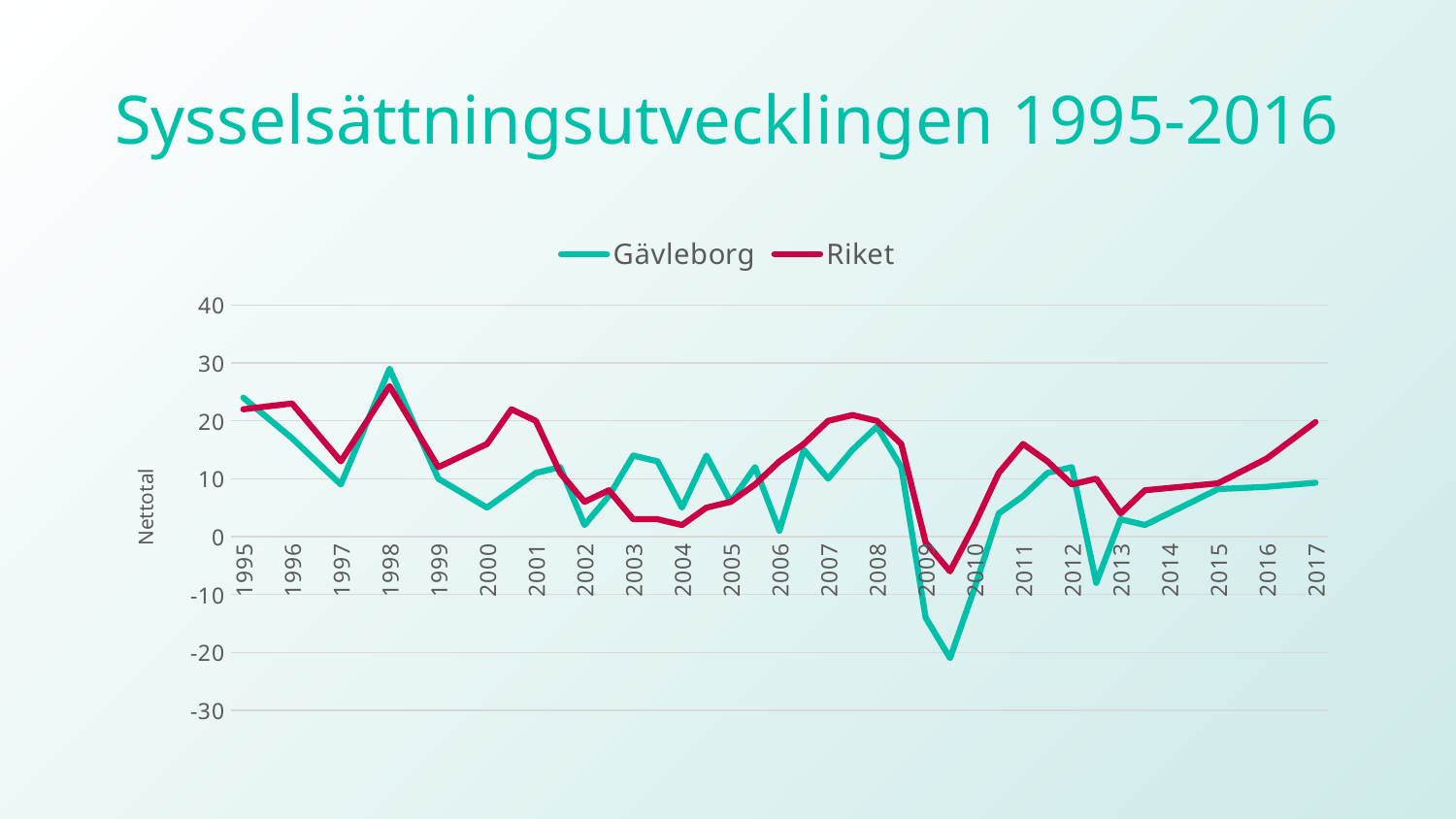
What kind of chart is shown on the slide? Line chart How many series does the legend list? 2 Does the Riket line rise or fall between 2013 and 2017? Rise Is the value for Gävleborg at 1998 greater or less than 20? greater Which series is higher at 2017, Gävleborg or Riket? Riket How many year labels are shown on the x axis? 23 What is the label on the vertical axis? Nettotal Is the lowest value for Gävleborg around 2009 greater or less than -10? less Which series reaches the lowest value on the chart? Gävleborg What is the title of the chart on the slide? Sysselsättningsutvecklingen 1995-2016 Is the value for Riket at 2017 greater or less than 10? greater